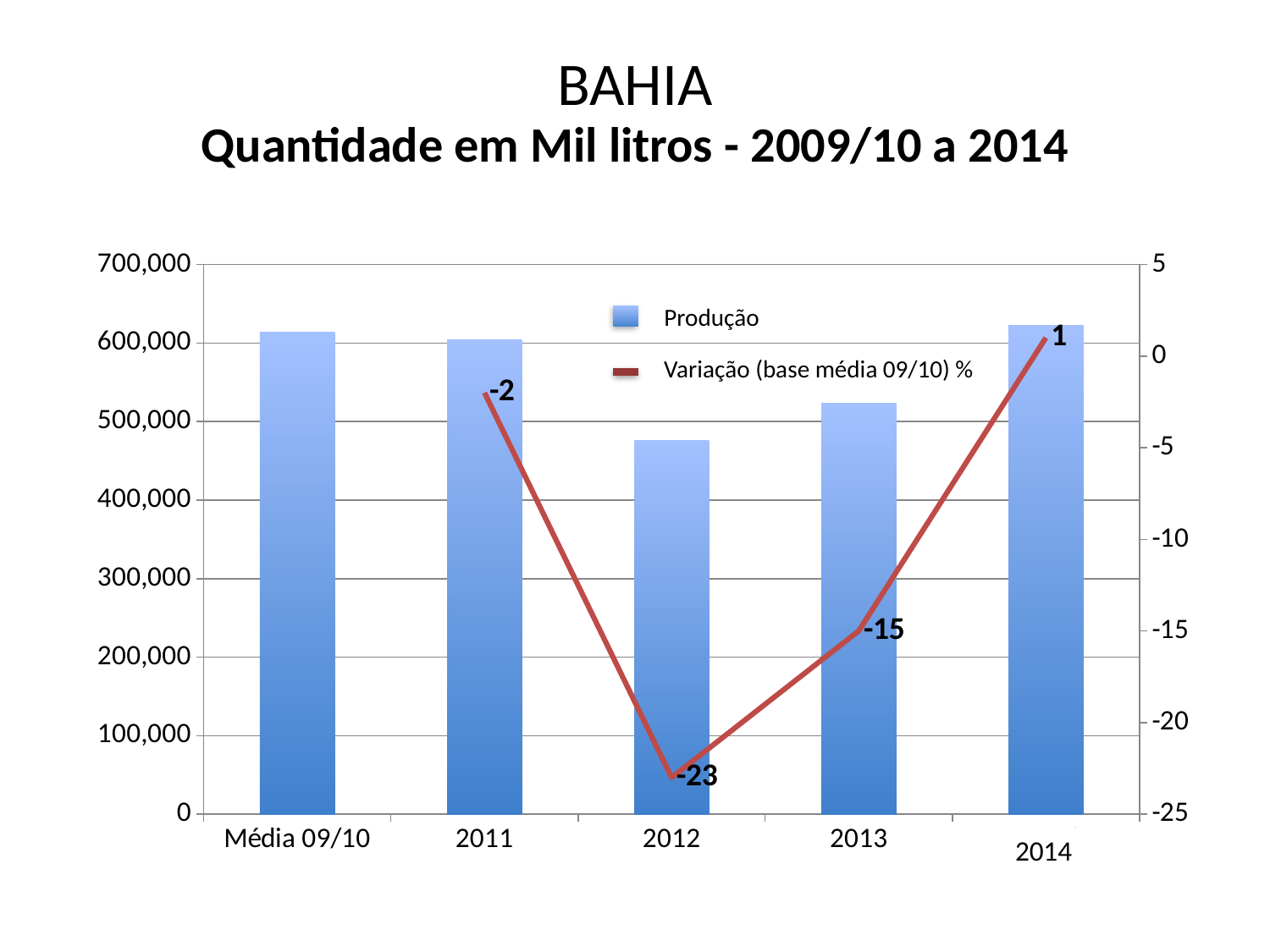
Does the Variação (base média 09/10) % line rise or fall from 2012 to 2014? rise What is the value of Variação (base média 09/10) % for 2014? 1 How many categories are shown on the x axis? 5 Which year has the lowest Variação (base média 09/10) %? 2012 Which year has the highest Variação (base média 09/10) %? 2014 What is the value of Variação (base média 09/10) % for 2011? -2 Is the Produção value for 2014 greater or less than 600,000? greater Which year has the lower Produção bar, 2012 or 2013? 2012 What is the value of Variação (base média 09/10) % for 2012? -23 Is the Produção value for 2012 greater or less than 500,000? less How many series does the legend list? 2 What is the difference between the Variação values for 2014 and 2012? 24